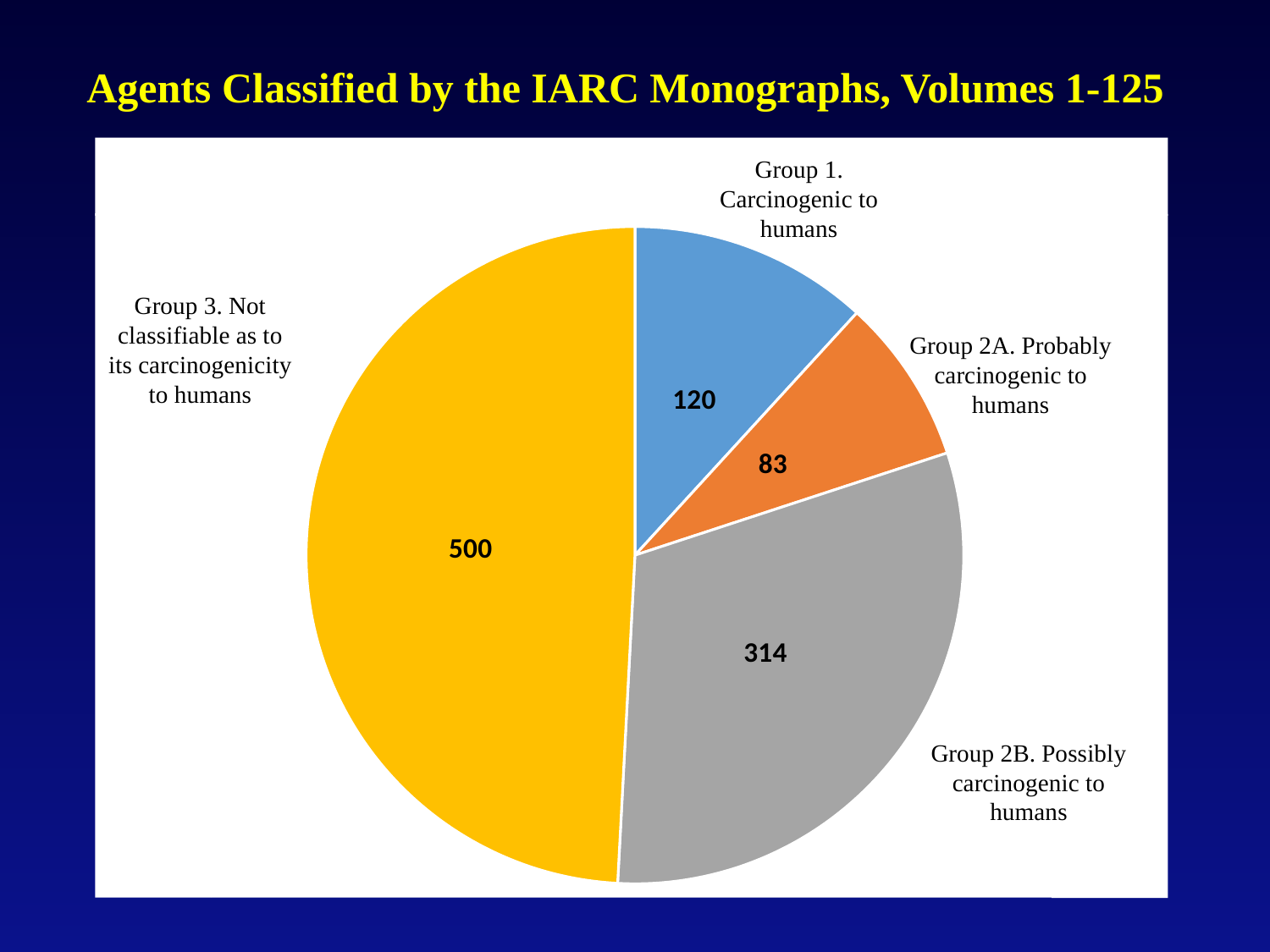
How many agents are in Group 1, Carcinogenic to humans? 120 Which group has the smallest slice of the pie? Group 2A. Probably carcinogenic to humans Which group has the largest slice of the pie? Group 3. Not classifiable as to its carcinogenicity to humans Which has more agents, Group 1 or Group 2B? Group 2B How many agents are in Group 2A, Probably carcinogenic to humans? 83 What is the difference between the number of agents in Group 3 and Group 2B? 186 What type of chart is shown on the slide? pie chart How many agents are in Group 2B, Possibly carcinogenic to humans? 314 How many groups (slices) are shown in the pie chart? 4 What is the title of the chart? Agents Classified by the IARC Monographs, Volumes 1-125 How many agents are in Group 3, Not classifiable as to its carcinogenicity to humans? 500 What is the difference between the number of agents in Group 1 and Group 2A? 37